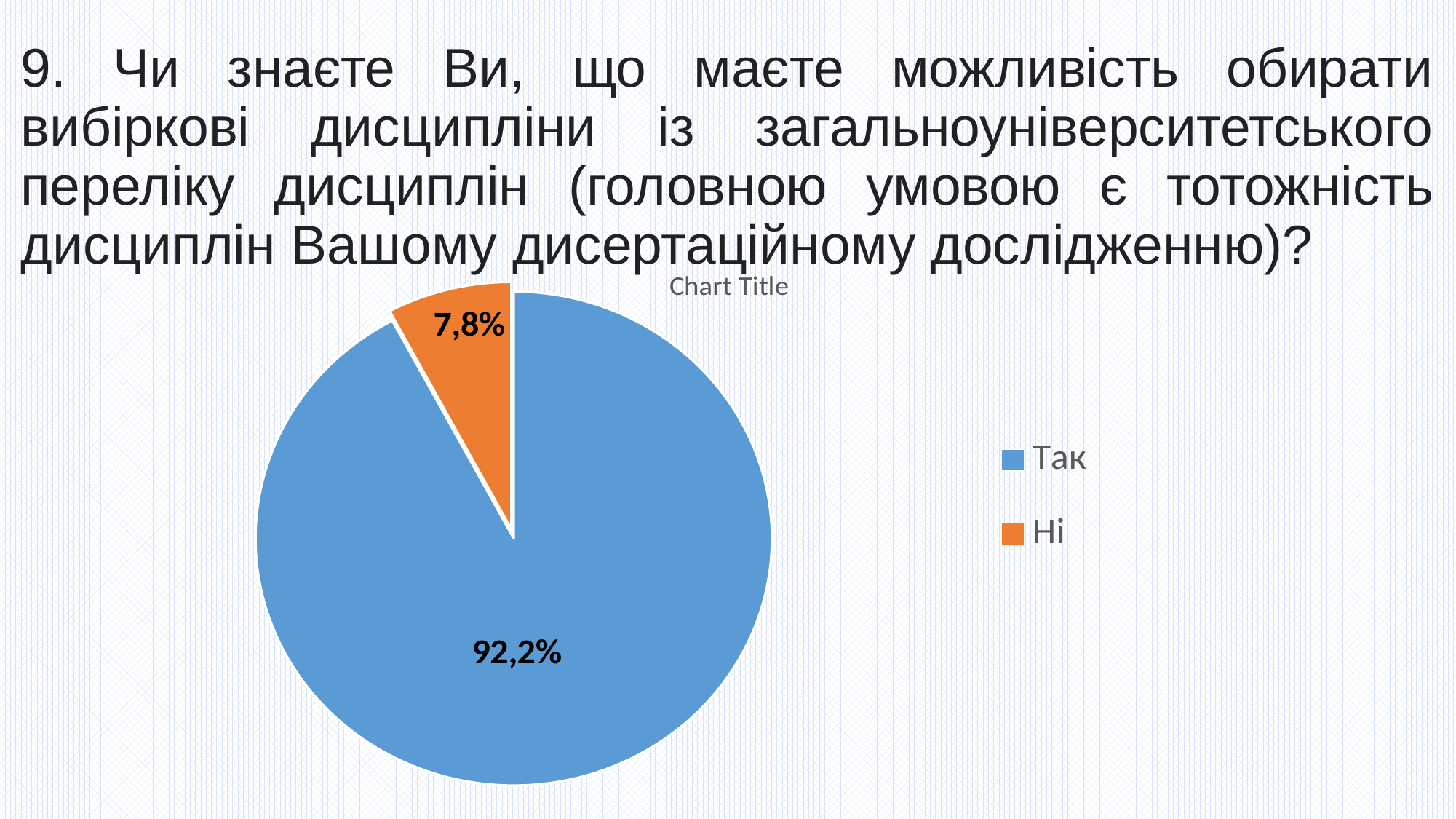
How many entries does the legend list? 2 Which category has the largest slice in the pie chart? Так Which category has the smallest slice in the pie chart? Ні What share of the pie does the "Ні" slice represent? 7,8% What is the difference between the "Так" and "Ні" values? 84,4% How many categories does the pie chart have? 2 What is the value for "Ні" in the pie chart? 7,8% Which is larger, the value for "Так" or the value for "Ні"? Так What colour is the "Так" slice in the pie chart? blue What is the title shown above the pie chart? Chart Title What type of chart is shown on the slide? pie chart What is the value for "Так" in the pie chart? 92,2%